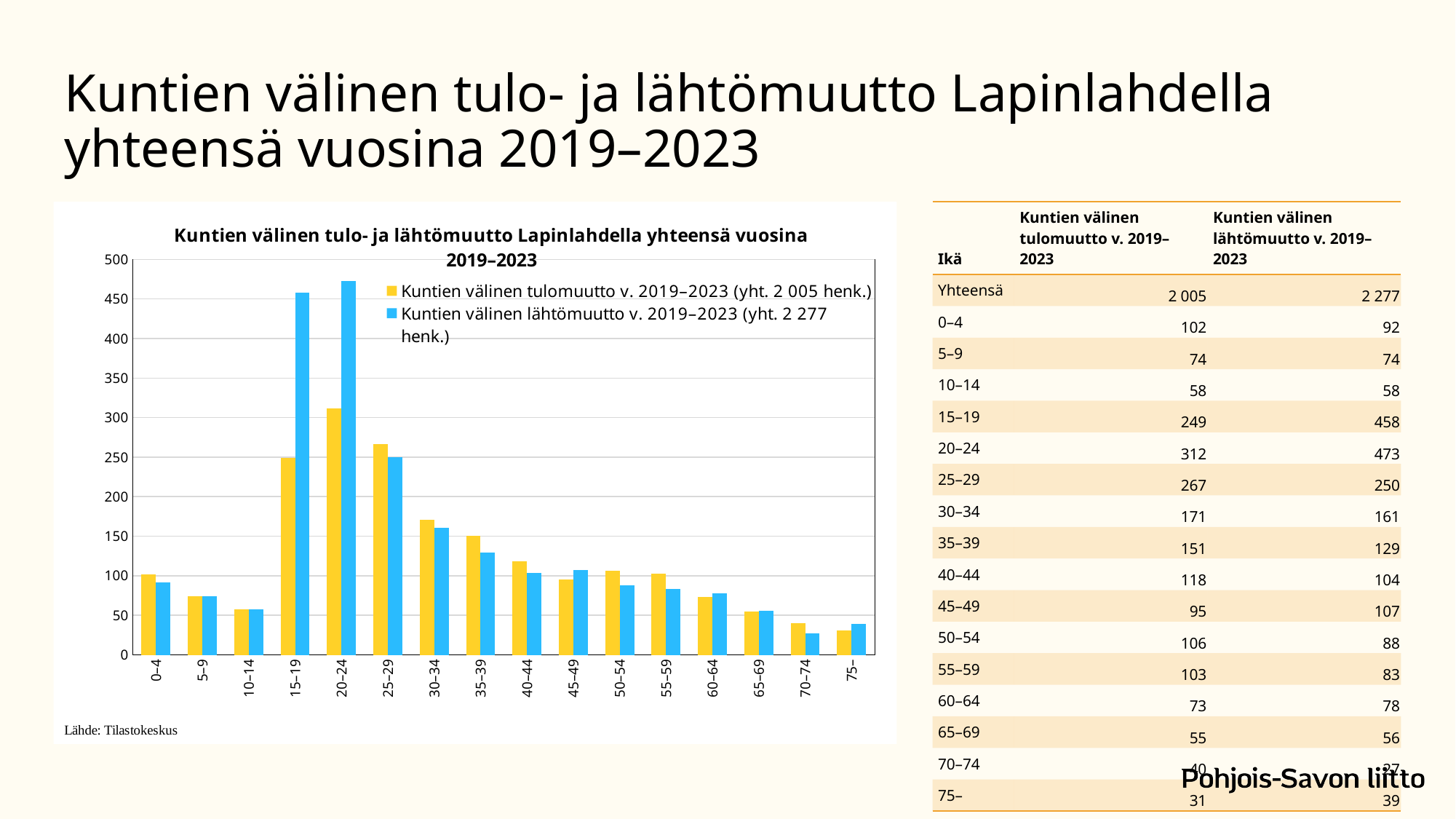
According to the legend, what is the total number of persons for Kuntien välinen tulomuutto v. 2019–2023? 2 005 henk. Which age group has the highest value for Kuntien välinen lähtömuutto v. 2019–2023? 20–24 How many series does the chart legend list? 2 How many age groups are shown on the x axis of the chart? 16 Which age group has the lowest value for Kuntien välinen lähtömuutto v. 2019–2023? 70–74 Is the value for Kuntien välinen tulomuutto in the 30–34 age group greater or less than 150? greater What is the value of Kuntien välinen lähtömuutto v. 2019–2023 for the 15–19 age group? 458 Which age group has the highest value for Kuntien välinen tulomuutto v. 2019–2023? 20–24 For the 25–29 age group, which is larger: tulomuutto or lähtömuutto? tulomuutto What is the value of Kuntien välinen tulomuutto v. 2019–2023 for the 15–19 age group? 249 What kind of chart is shown on the slide? bar chart For the 20–24 age group, how much larger is lähtömuutto than tulomuutto? 161